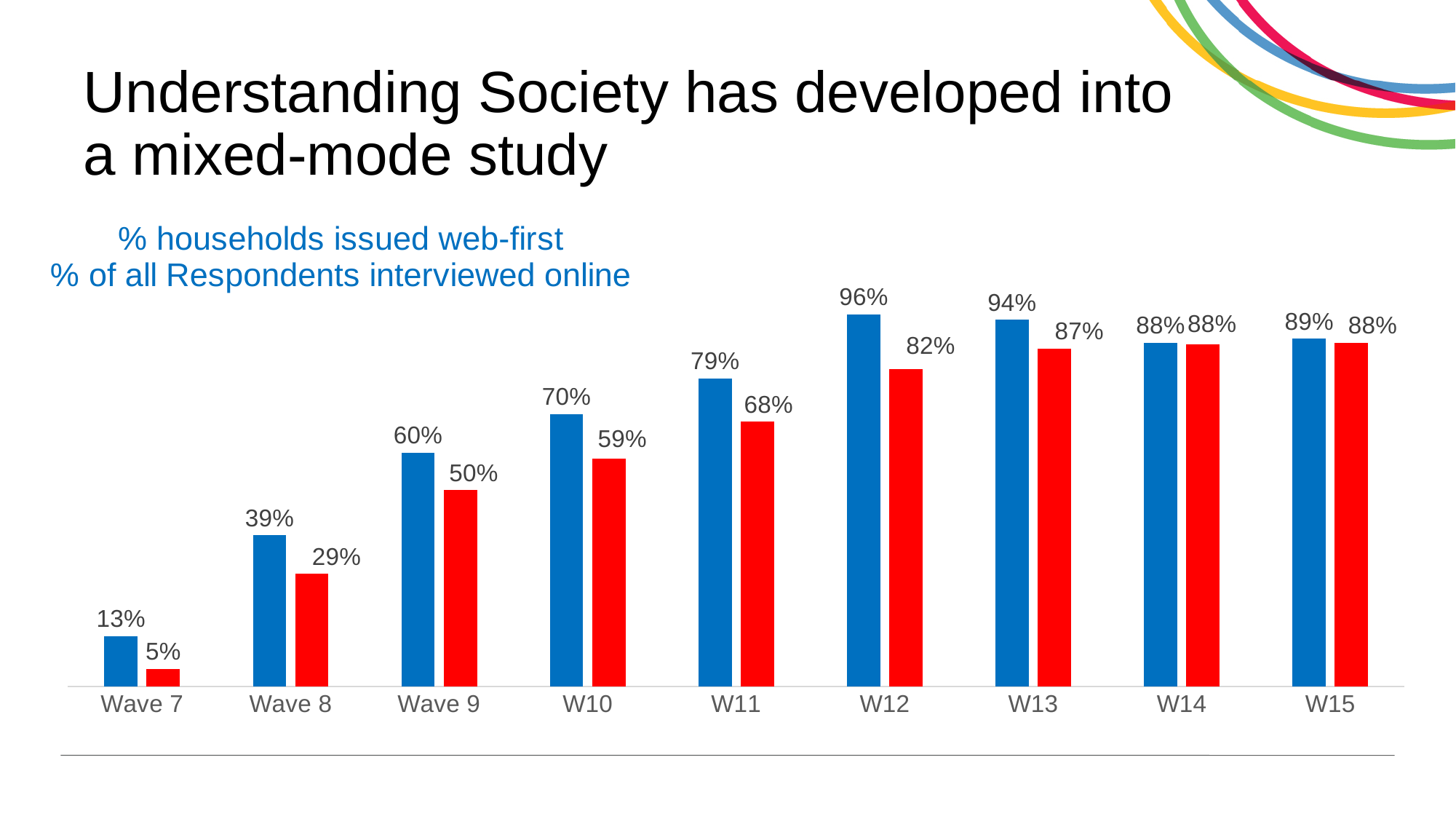
What is the value of the blue bar for Wave 7? 13% What are the two series labels written above the chart? % households issued web-first; % of all Respondents interviewed online What type of chart is shown on the slide? bar chart Which is larger for Wave 8: the blue bar or the red bar? the blue bar In which wave is the red bar lowest? Wave 7 How many waves (categories) are shown on the x axis of the chart? 9 What is the value of the red bar for W11? 68% In which wave is the blue bar highest? W12 What is the value of the red bar for Wave 9? 50% What is the difference between the blue bar and the red bar for W12? 14 percentage points Do the red bar values generally rise or fall from Wave 7 to W15? rise How many series does the chart show? 2